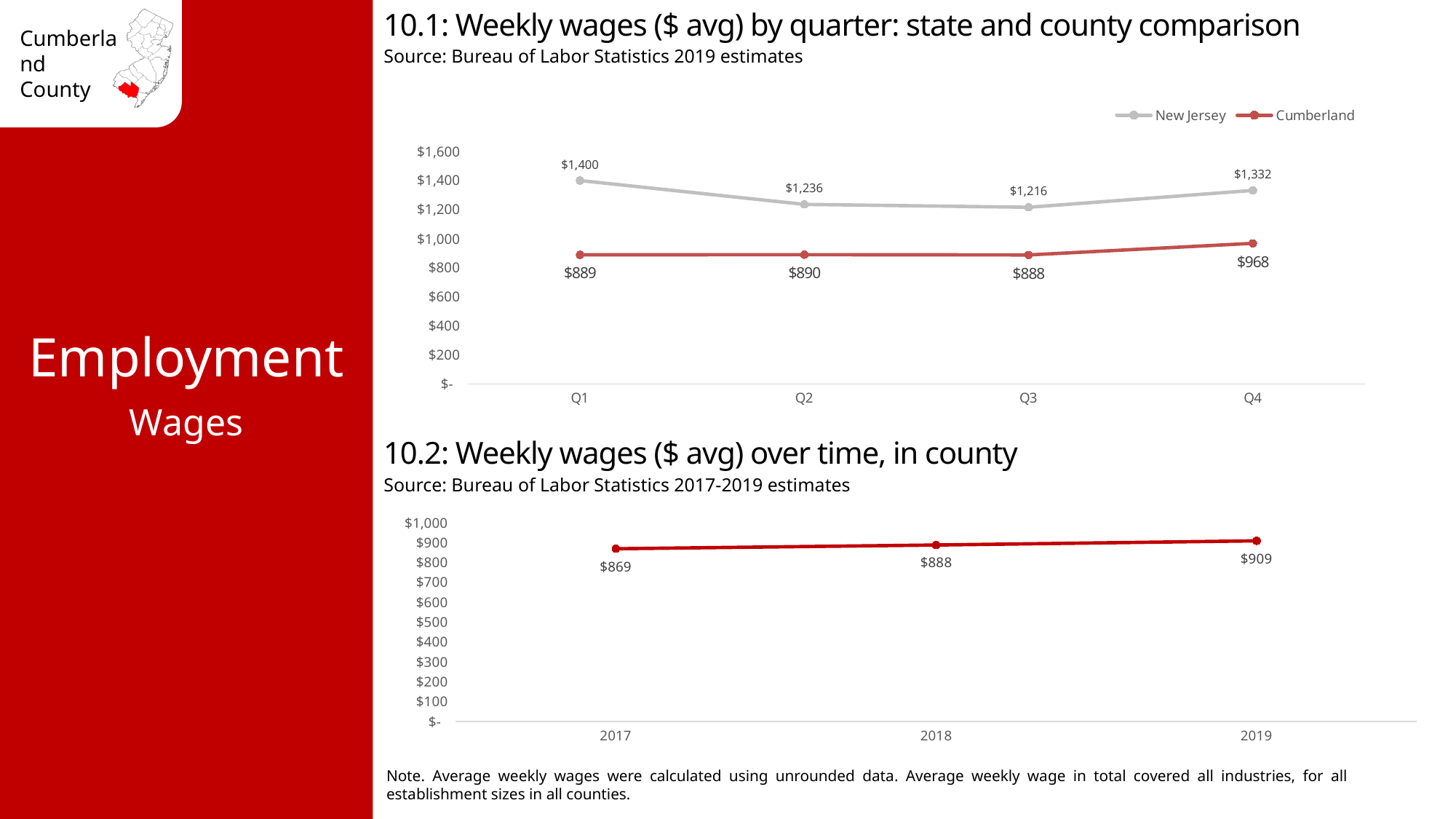
What kind of chart is chart 10.2 (weekly wages over time, in county)? line chart In chart 10.1 (weekly wages by quarter), is the Cumberland value for Q2 greater or less than $1,000? less In chart 10.1 (weekly wages by quarter), what is the New Jersey value for Q1? $1,400 In chart 10.1 (weekly wages by quarter), what is the difference between the New Jersey and Cumberland values in Q1? $511 In chart 10.1 (weekly wages by quarter), what is the Cumberland value for Q4? $968 In chart 10.1 (weekly wages by quarter), how many series does the legend list? 2 In chart 10.2 (weekly wages over time, in county), how many years are plotted? 3 In chart 10.1 (weekly wages by quarter), which quarter has the lowest New Jersey value? Q3 In chart 10.2 (weekly wages over time, in county), what is the difference between the 2019 and 2017 values? $40 In chart 10.2 (weekly wages over time, in county), what is the value for 2018? $888 In chart 10.2 (weekly wages over time, in county), do the values rise or fall from 2017 to 2019? rise In chart 10.1 (weekly wages by quarter), which quarter has the highest Cumberland value? Q4